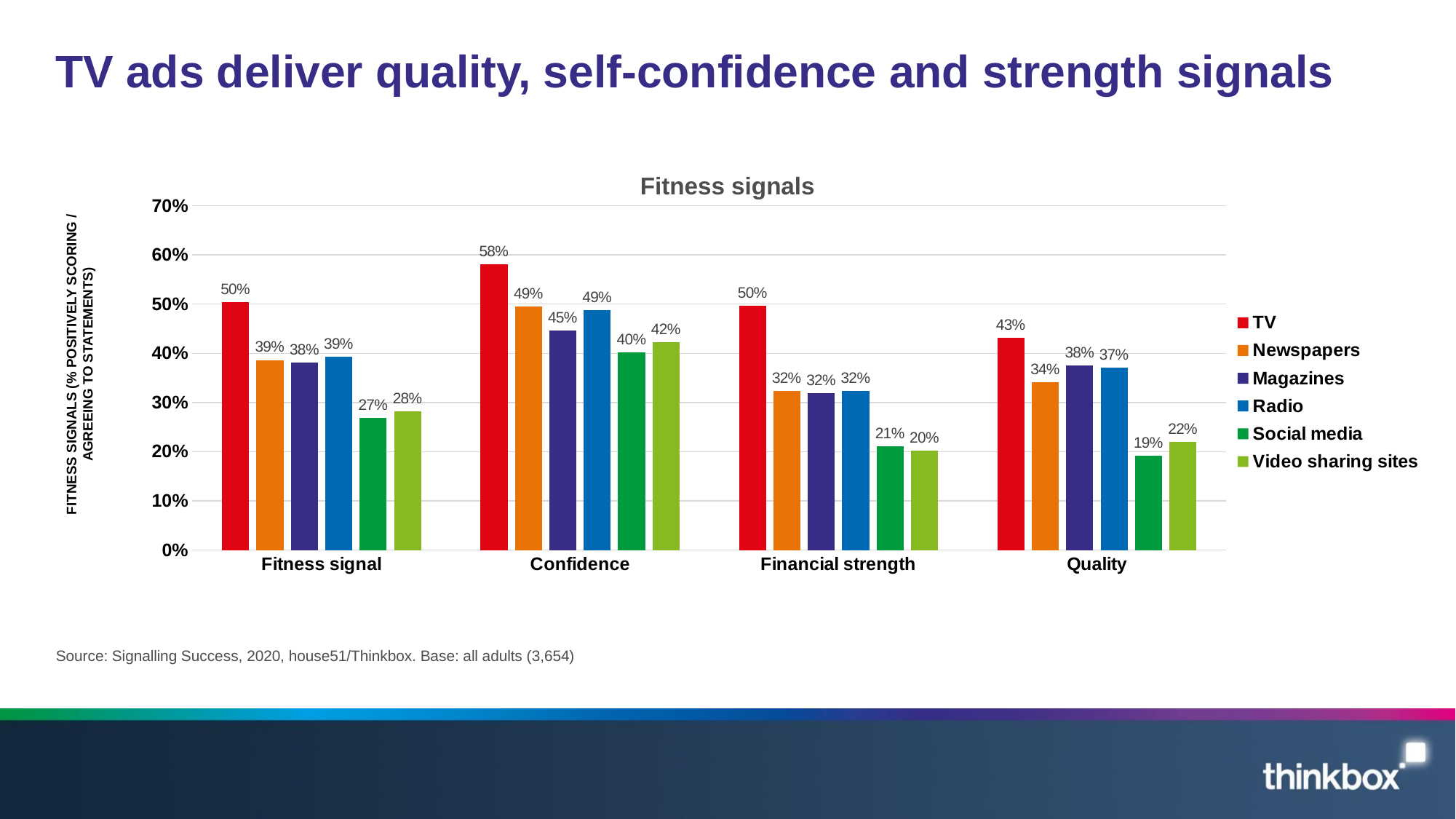
What kind of chart is shown on the slide? bar chart How many categories are shown on the x axis? 4 What is the value for Radio in the Fitness signal category? 39% Which series has the highest value in the Financial strength category? TV What is the title of the chart? Fitness signals What is the difference between the TV value and the Newspapers value in the Quality category? 9% Which is larger in the Confidence category: Magazines or Radio? Radio What is the value for Social media in the Quality category? 19% How many series does the legend list? 6 Which series has the lowest value in the Quality category? Social media Is the value for Video sharing sites in the Financial strength category greater or less than 30%? less What is the value for TV in the Confidence category? 58%